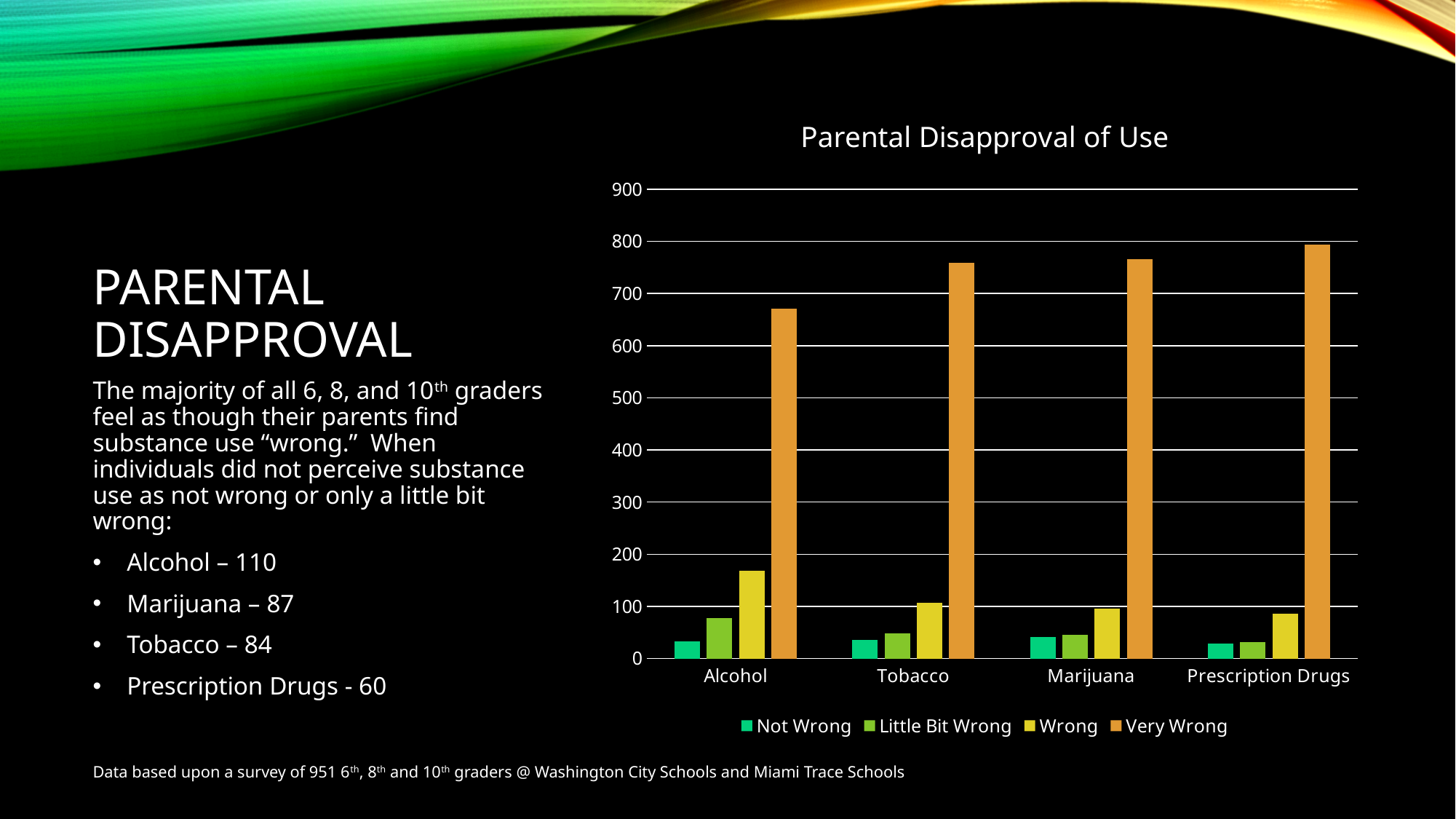
Which series is shown in orange in the legend? Very Wrong Is the Wrong value for Alcohol greater or less than 100? greater How many series does the chart legend list? 4 Which is larger, the Very Wrong value for Alcohol or the Very Wrong value for Tobacco? Tobacco Is the Very Wrong value for Tobacco greater or less than 700? greater Is the Very Wrong value for Alcohol greater or less than 700? less What kind of chart is shown on the slide? bar chart What is the title of the chart? Parental Disapproval of Use Which category has the highest Wrong value? Alcohol How many substance categories are shown on the x axis? 4 Which category has the lowest Very Wrong value? Alcohol